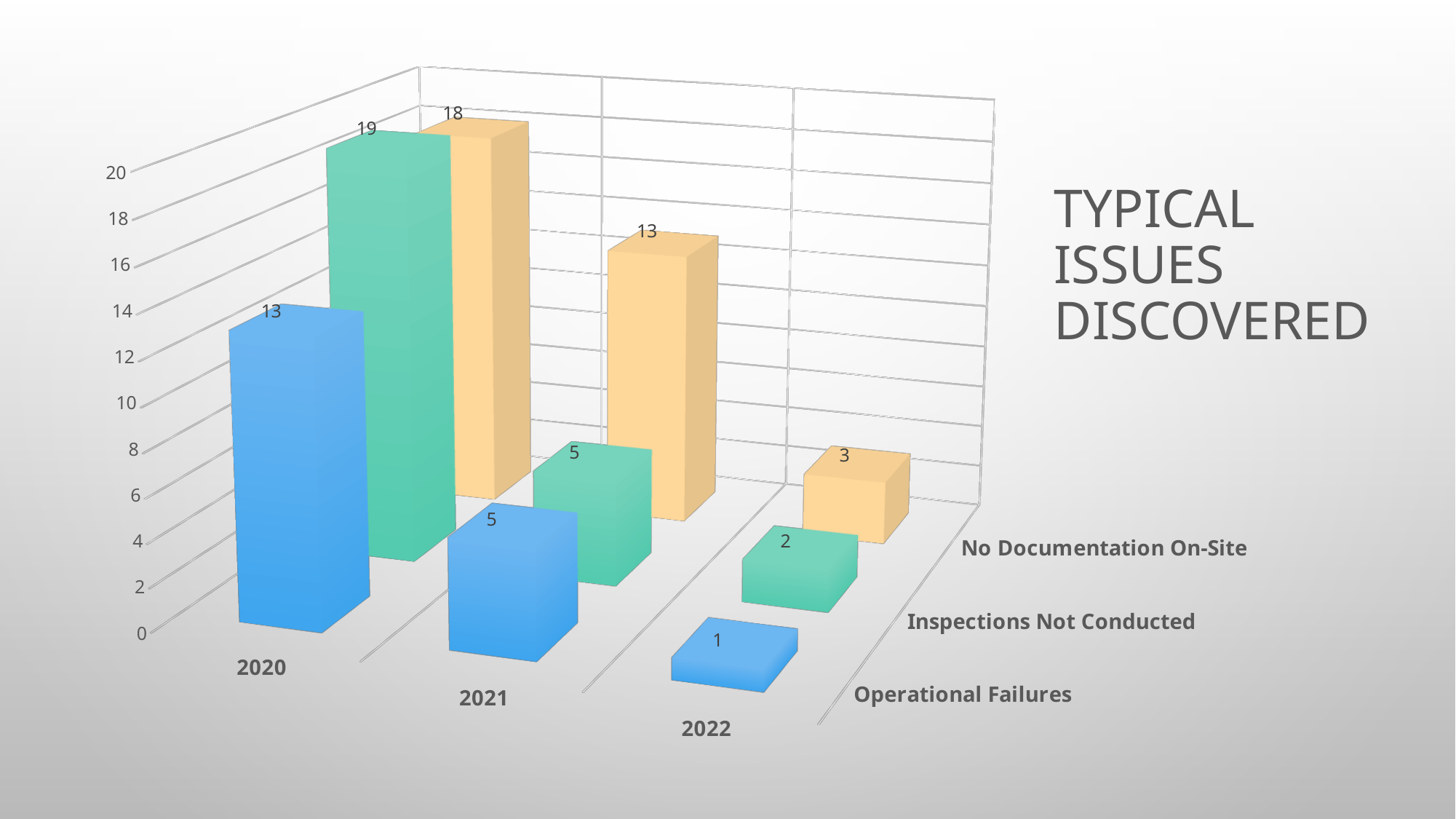
What is the difference between the Inspections Not Conducted value in 2020 and in 2021? 14 Do the values for Operational Failures rise or fall from 2020 to 2022? Fall What is the value for Operational Failures in 2020? 13 What is the value for No Documentation On-Site in 2021? 13 What is the value for Operational Failures in 2022? 1 How many years are shown on the x axis? 3 What is the value for Inspections Not Conducted in 2020? 19 Which year has the highest value for No Documentation On-Site? 2020 What type of chart is shown on the slide? Bar chart Which is larger in 2021: Operational Failures or No Documentation On-Site? No Documentation On-Site What is the title of the slide? TYPICAL ISSUES DISCOVERED Which year has the lowest value for Inspections Not Conducted? 2022